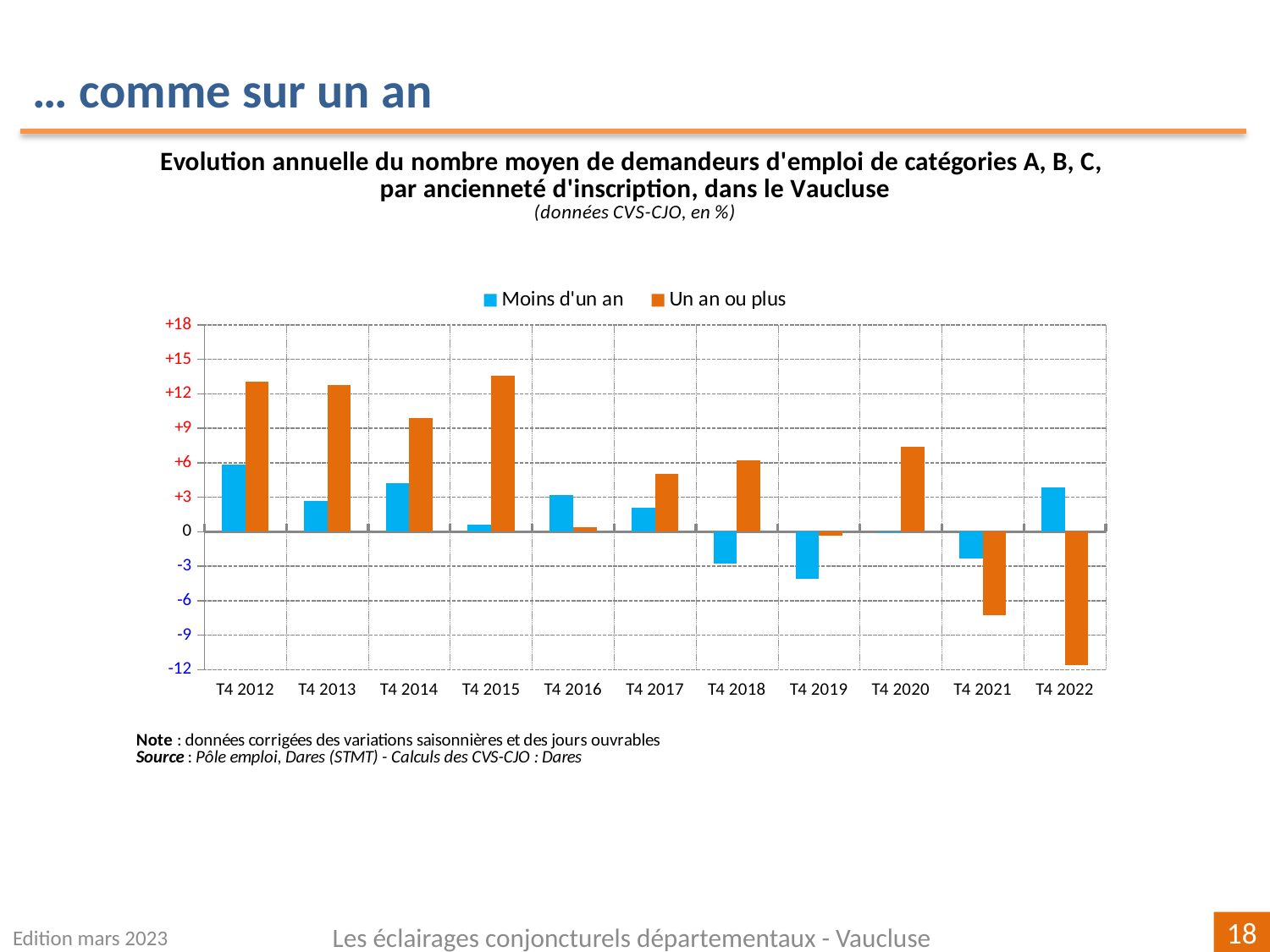
Is the value for 'Un an ou plus' in T4 2020 greater or less than +6? greater Which quarter has the highest value for the 'Moins d'un an' series? T4 2012 Which quarter has the lowest value for the 'Moins d'un an' series? T4 2019 What kind of chart is shown on the slide? bar chart Is the value for 'Moins d'un an' in T4 2019 greater or less than -3? less Is the value for 'Un an ou plus' in T4 2022 greater or less than -9? less In T4 2018, which series has the larger value, 'Moins d'un an' or 'Un an ou plus'? Un an ou plus Which quarter has the lowest value for the 'Un an ou plus' series? T4 2022 How many series does the legend list? 2 How many quarters (categories) are shown on the x axis? 11 Which colour represents the 'Un an ou plus' series in the legend? orange